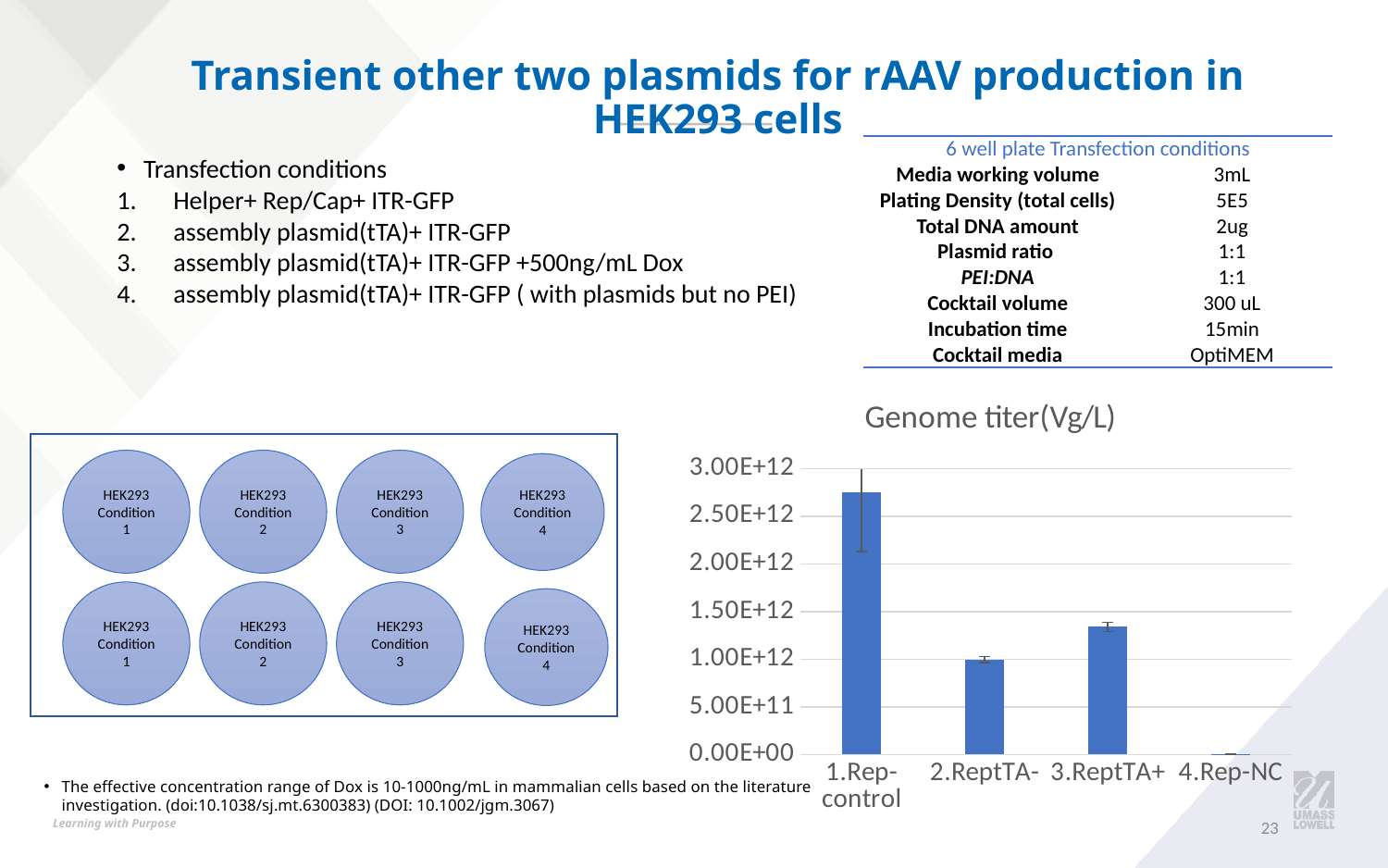
What is the highest tick value shown on the y axis of the Genome titer(Vg/L) chart? 3.00E+12 Is the value for 3.ReptTA+ in the Genome titer(Vg/L) chart greater or less than 1.00E+12? greater Which category has the lowest genome titer in the Genome titer(Vg/L) chart? 4.Rep-NC In the Genome titer(Vg/L) chart, which is larger, the value for 1.Rep-control or 3.ReptTA+? 1.Rep-control How many categories are shown on the x axis of the Genome titer(Vg/L) chart? 4 Which category has the highest genome titer in the Genome titer(Vg/L) chart? 1.Rep-control Is the value for 3.ReptTA+ in the Genome titer(Vg/L) chart greater or less than 1.50E+12? less In the Genome titer(Vg/L) chart, which is larger, the value for 2.ReptTA- or 3.ReptTA+? 3.ReptTA+ Is the value for 1.Rep-control in the Genome titer(Vg/L) chart greater or less than 2.00E+12? greater What is the title of the bar chart on the slide? Genome titer(Vg/L) What kind of chart is the Genome titer(Vg/L) chart? bar chart